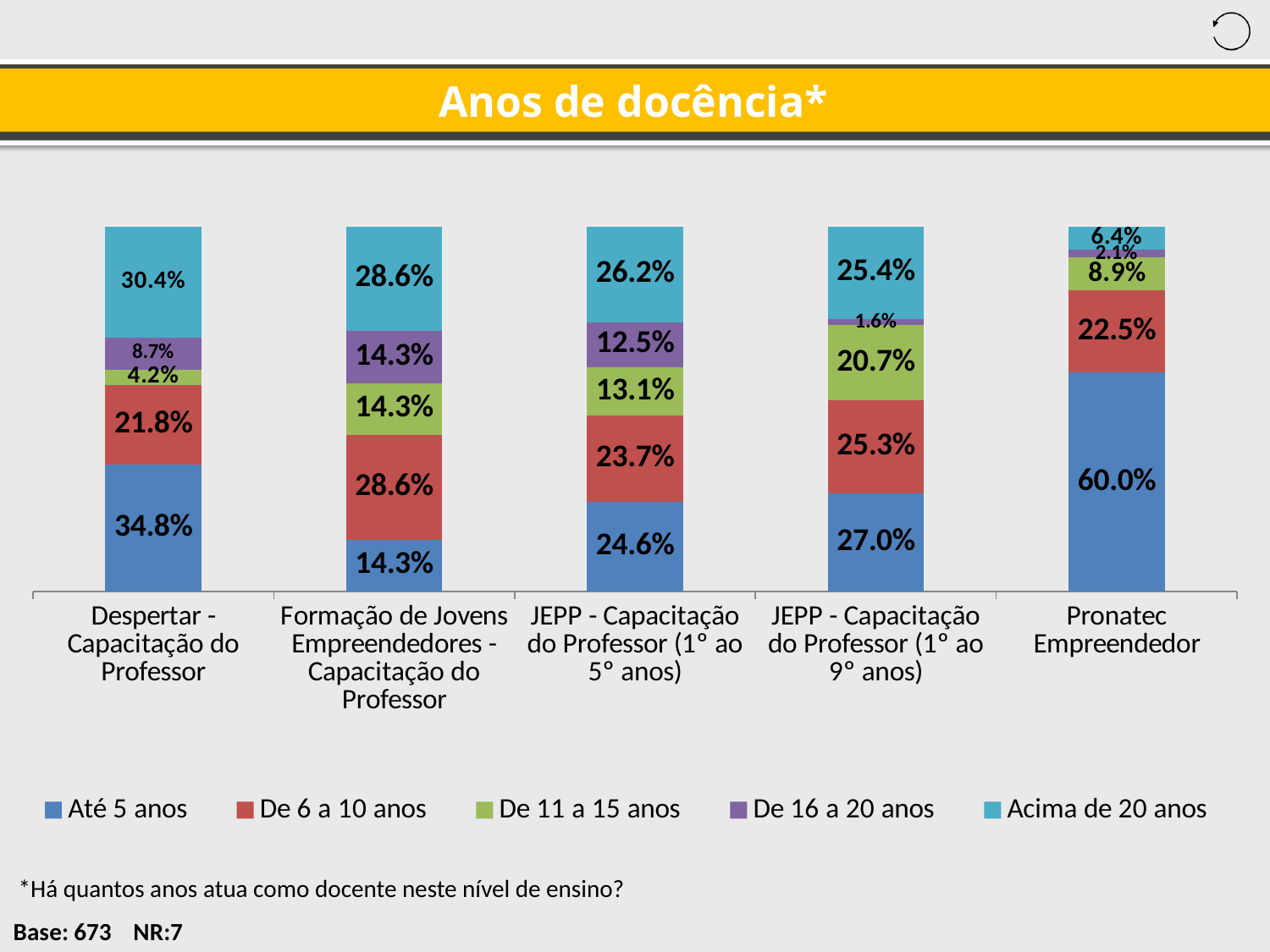
What is the value of 'De 16 a 20 anos' for JEPP - Capacitação do Professor (1° ao 9° anos)? 1.6% What is the title of the chart? Anos de docência* Which is larger for Formação de Jovens Empreendedores - Capacitação do Professor: 'Até 5 anos' or 'De 6 a 10 anos'? De 6 a 10 anos What is the value of 'Acima de 20 anos' for Despertar - Capacitação do Professor? 30.4% How many categories (programs) are shown on the x axis? 5 How many series does the legend list? 5 What is the value of 'De 11 a 15 anos' for JEPP - Capacitação do Professor (1° ao 5° anos)? 13.1% What is the difference between 'Até 5 anos' and 'De 6 a 10 anos' for Despertar - Capacitação do Professor? 13.0% What is the value of 'Até 5 anos' for Pronatec Empreendedor? 60.0% What kind of chart is shown on the slide? Stacked bar chart Which category has the lowest value for 'Acima de 20 anos'? Pronatec Empreendedor Which category has the highest value for 'Até 5 anos'? Pronatec Empreendedor